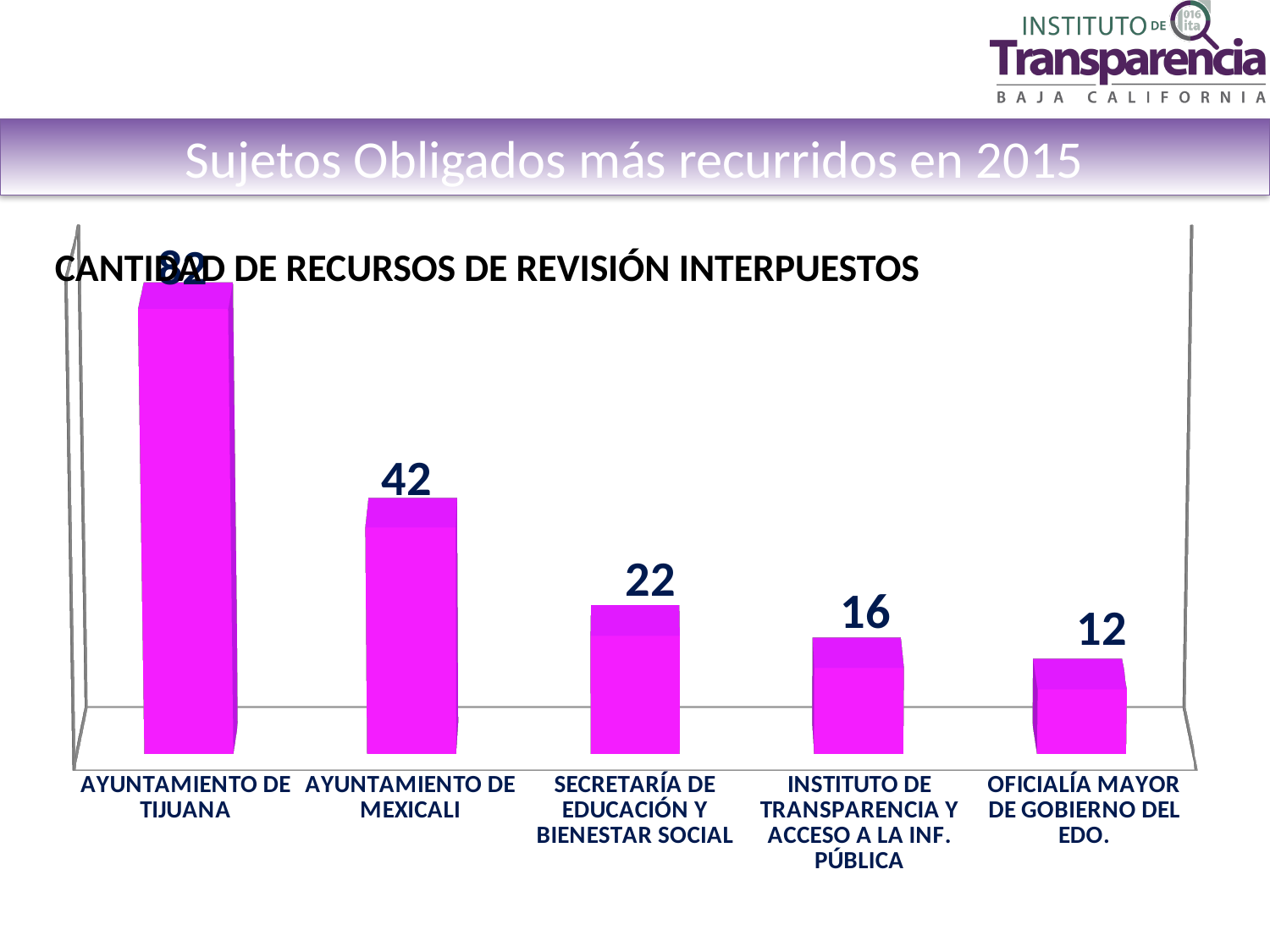
What is the value for Instituto de Transparencia y Acceso a la Inf. Pública? 16 What kind of chart is shown on the slide? Bar chart Do the values rise or fall from left to right across the categories? Fall What is the value for Oficialía Mayor de Gobierno del Edo.? 12 Which is larger, the value for Secretaría de Educación y Bienestar Social or the value for Instituto de Transparencia y Acceso a la Inf. Pública? Secretaría de Educación y Bienestar Social How many categories are shown in the chart? 5 What is the value for Ayuntamiento de Mexicali? 42 What is the difference between the values for Instituto de Transparencia y Acceso a la Inf. Pública and Oficialía Mayor de Gobierno del Edo.? 4 Which category has the highest value? Ayuntamiento de Tijuana What is the difference between the values for Ayuntamiento de Mexicali and Secretaría de Educación y Bienestar Social? 20 Which category has the lowest value? Oficialía Mayor de Gobierno del Edo. What is the value for Secretaría de Educación y Bienestar Social? 22